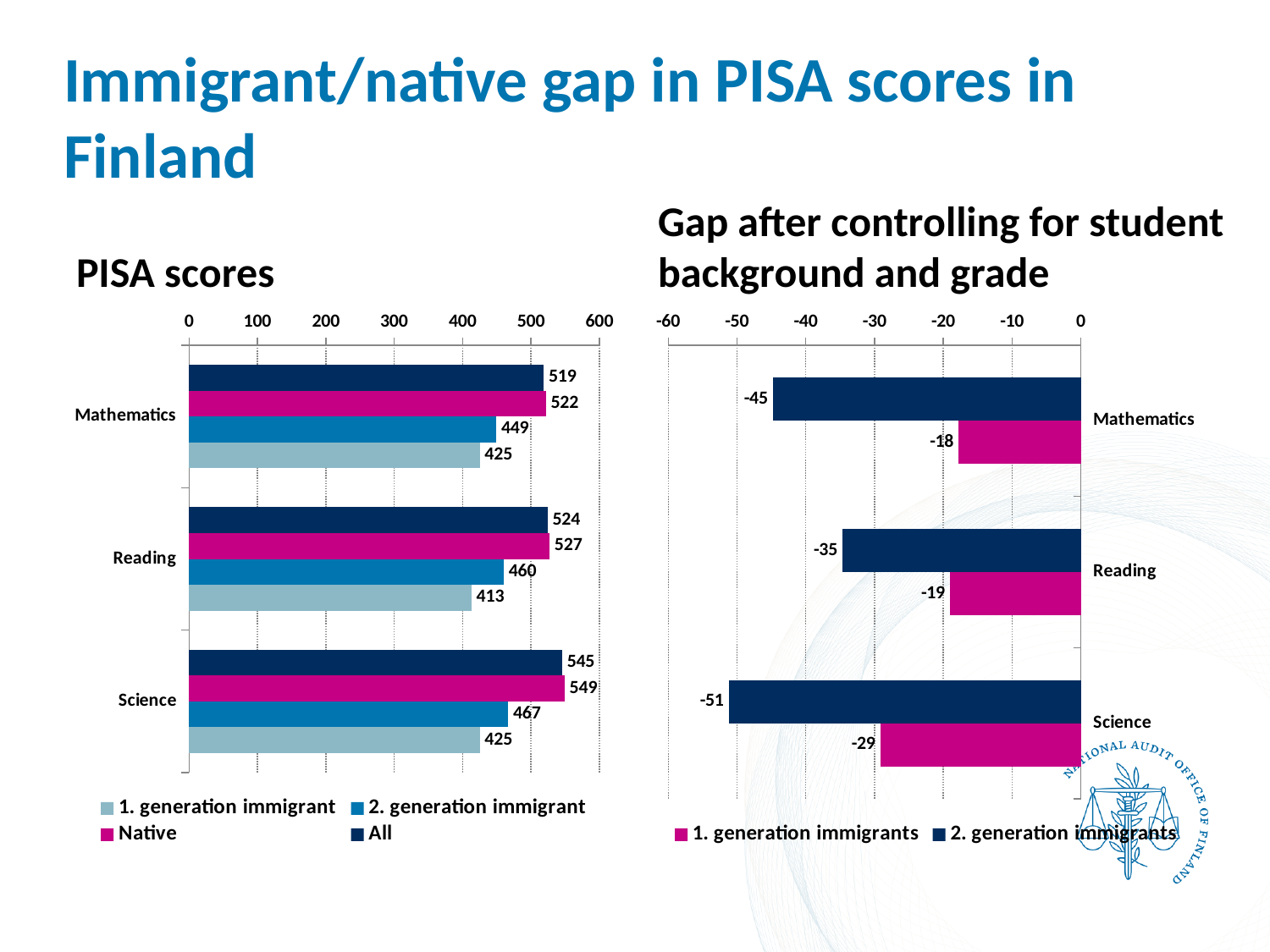
In the 'Gap after controlling for student background and grade' chart, what is the value for 2. generation immigrants in Mathematics? -45 In the PISA scores chart, which subject has the lowest 1. generation immigrant score? Reading What kind of chart is the 'Gap after controlling for student background and grade' chart? Bar chart In the PISA scores chart, what is the difference between the Native and 1. generation immigrant scores for Reading? 114 In the 'Gap after controlling for student background and grade' chart, which subject has the largest negative gap for 2. generation immigrants? Science How many series does the legend of the PISA scores chart list? 4 In the PISA scores chart, which subject has the highest score for All students? Science In the PISA scores chart, what is the 2. generation immigrant score for Mathematics? 449 In the 'Gap after controlling for student background and grade' chart, what is the value for 1. generation immigrants in Science? -29 In the PISA scores chart, what is the 1. generation immigrant score for Science? 425 In the PISA scores chart, what is the Native score for Reading? 527 In the 'Gap after controlling for student background and grade' chart, how many subject categories are shown? 3